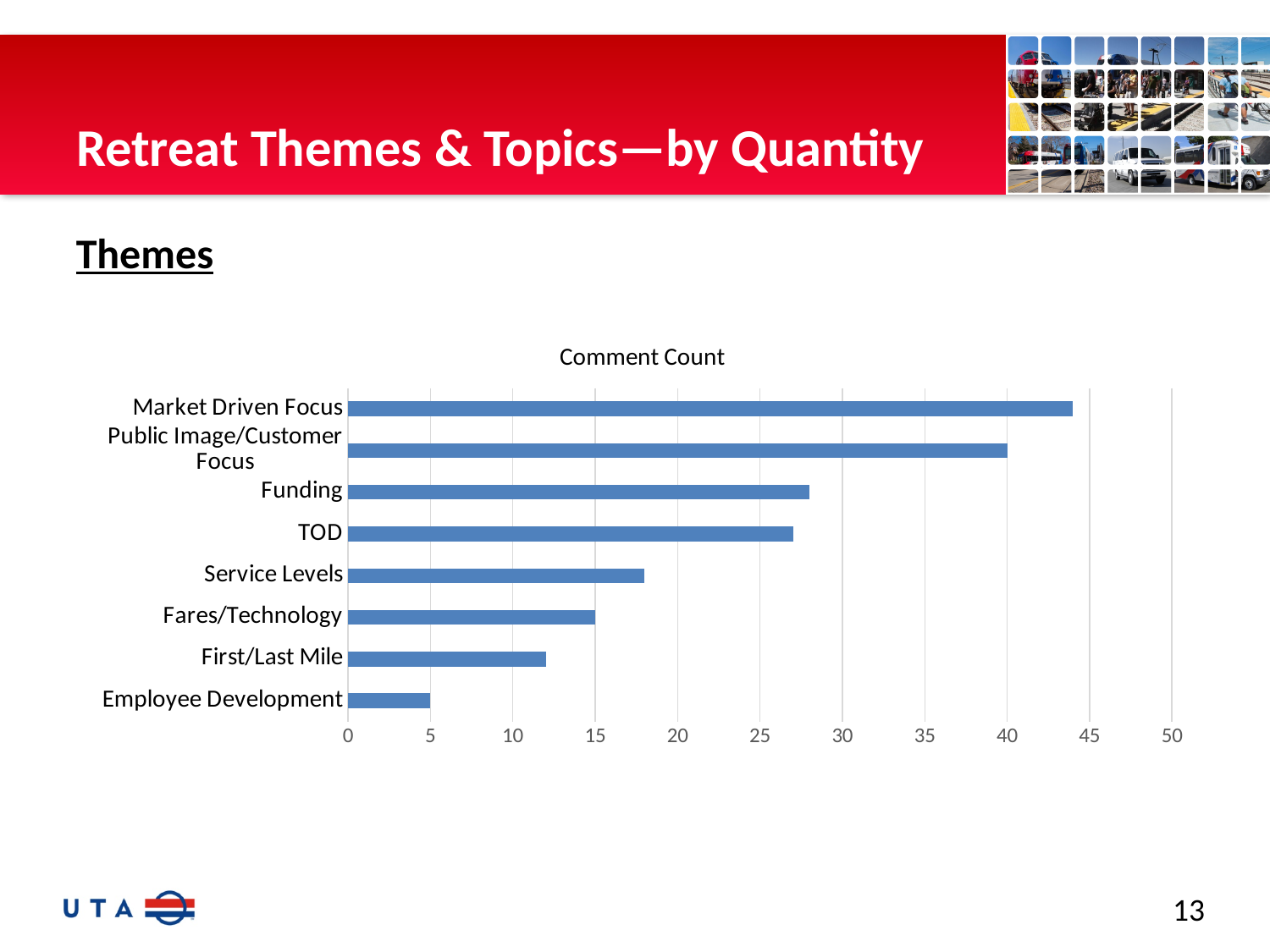
Which theme has the highest comment count? Market Driven Focus Which theme has the lowest comment count? Employee Development Which has a higher comment count, Public Image/Customer Focus or Funding? Public Image/Customer Focus How many themes are plotted in the chart? 8 Is the comment count for First/Last Mile greater or less than 10? greater Is the comment count for Market Driven Focus greater or less than 40? greater What is the highest value shown on the x axis of the chart? 50 Which has a higher comment count, Service Levels or Fares/Technology? Service Levels What type of chart is shown on the slide? bar chart What is the title of the chart? Comment Count Is the comment count for Funding greater or less than 25? greater